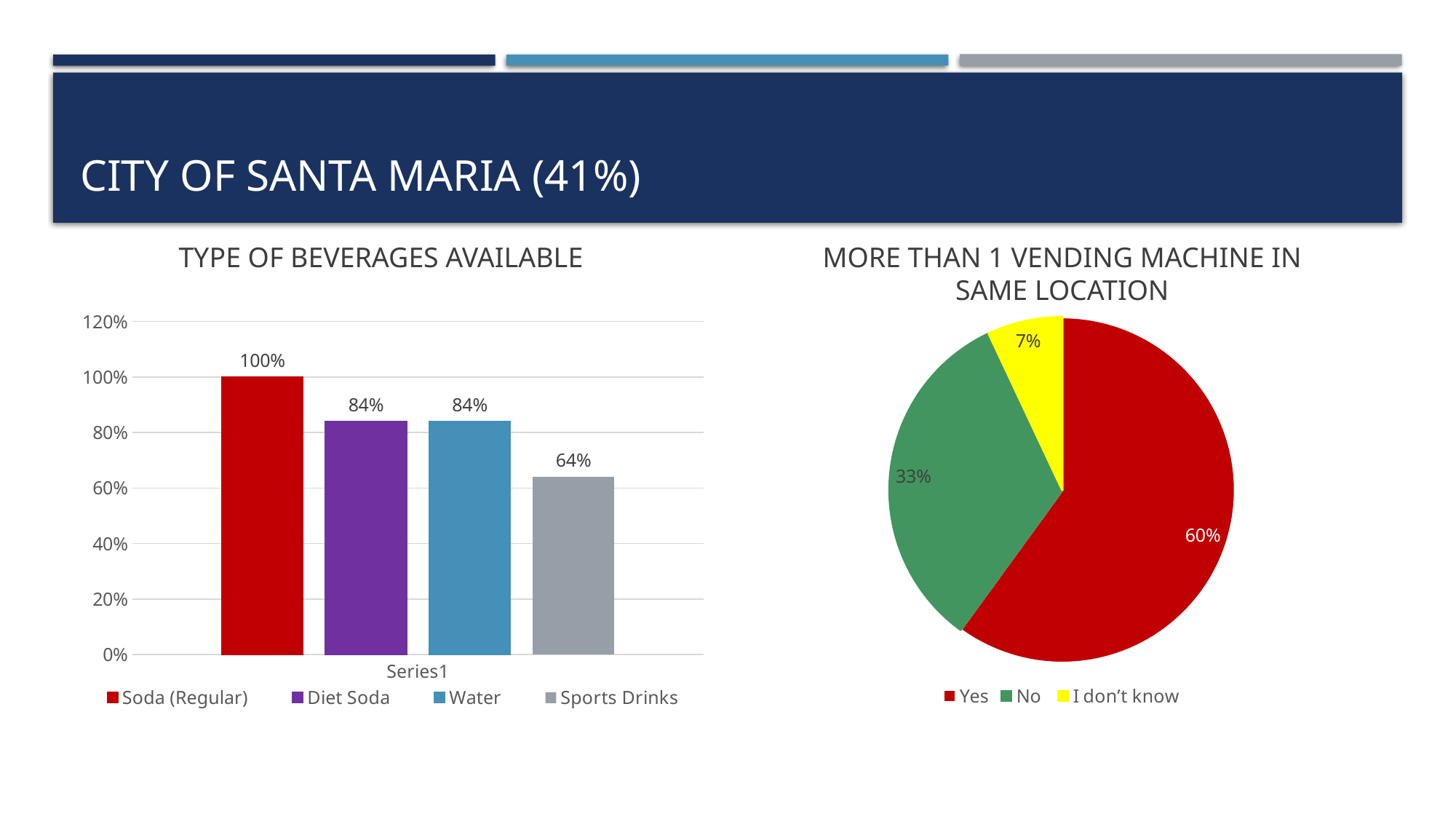
In the 'Type of Beverages Available' chart, what is the difference between the values for Soda (Regular) and Sports Drinks? 36% In the 'More Than 1 Vending Machine in Same Location' chart, what colour is the 'Yes' slice? Red In the 'More Than 1 Vending Machine in Same Location' chart, what share of the pie is 'No'? 33% In the 'Type of Beverages Available' chart, what is the value for Sports Drinks? 64% In the 'More Than 1 Vending Machine in Same Location' chart, which slice is the largest? Yes In the 'Type of Beverages Available' chart, how many beverage categories are shown? 4 In the 'More Than 1 Vending Machine in Same Location' chart, what share of the pie is 'I don't know'? 7% In the 'Type of Beverages Available' chart, what is the value for Diet Soda? 84% In the 'Type of Beverages Available' chart, which beverage has the highest value? Soda (Regular) In the 'More Than 1 Vending Machine in Same Location' chart, how many entries does the legend list? 3 What kind of chart is 'Type of Beverages Available'? Bar chart In the 'Type of Beverages Available' chart, which beverage has the lowest value? Sports Drinks